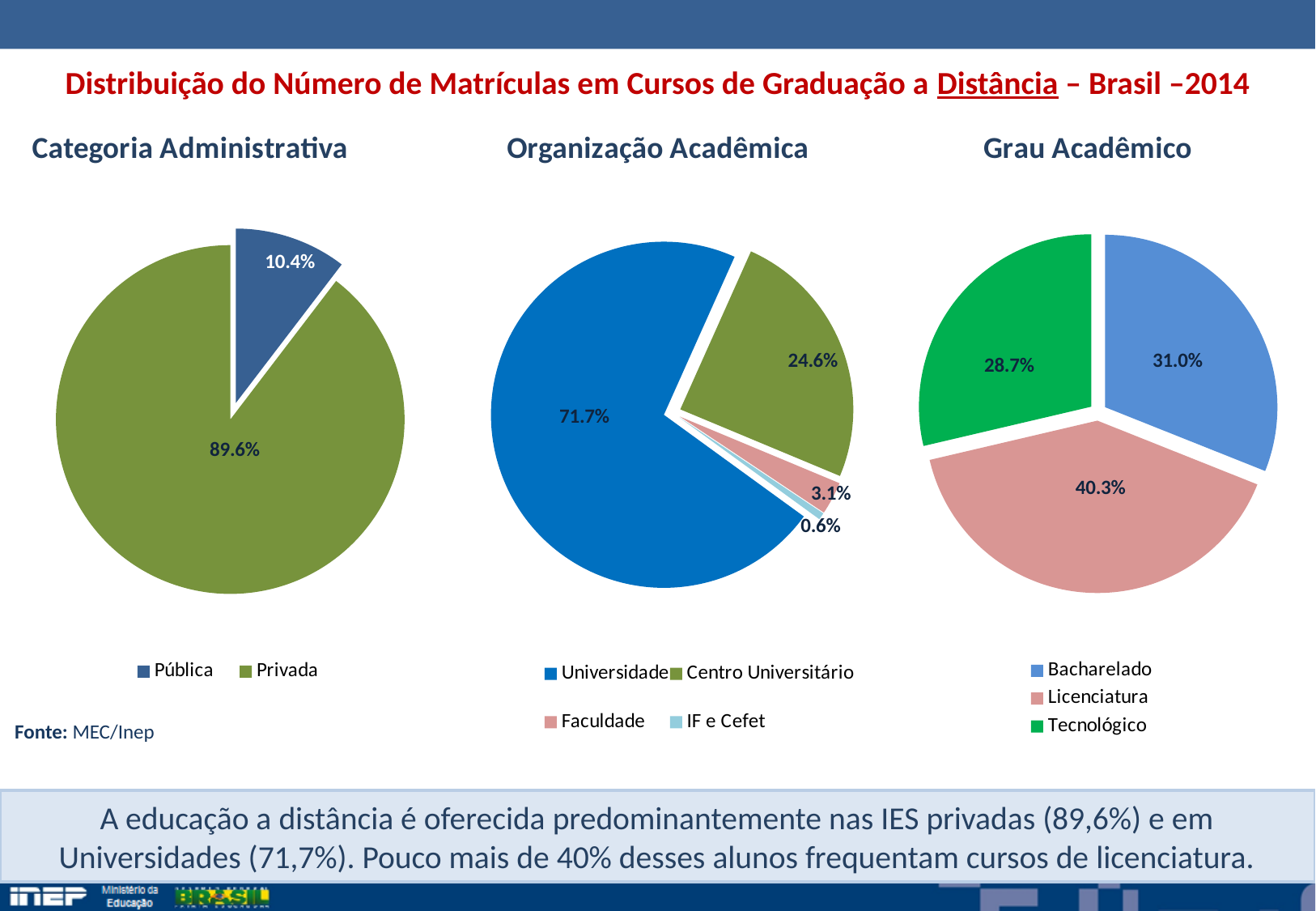
In the 'Grau Acadêmico' chart, which is larger, Bacharelado or Tecnológico? Bacharelado In the 'Organização Acadêmica' chart, what share is Universidade? 71.7% In the 'Categoria Administrativa' chart, what share of enrolments is Pública? 10.4% In the 'Grau Acadêmico' chart, what share is Licenciatura? 40.3% In the 'Grau Acadêmico' chart, what is the difference between the Bacharelado and Tecnológico shares? 2.3% In the 'Categoria Administrativa' chart, what share of enrolments is Privada? 89.6% In the 'Organização Acadêmica' chart, what share is Faculdade? 3.1% In the 'Organização Acadêmica' chart, which category has the smallest share? IF e Cefet In the 'Grau Acadêmico' chart, which category has the largest share? Licenciatura In the 'Organização Acadêmica' chart, how many categories does the legend list? 4 In the 'Organização Acadêmica' chart, what is the combined share of Centro Universitário and Faculdade? 27.7% What kind of chart is used for 'Categoria Administrativa'? Pie chart